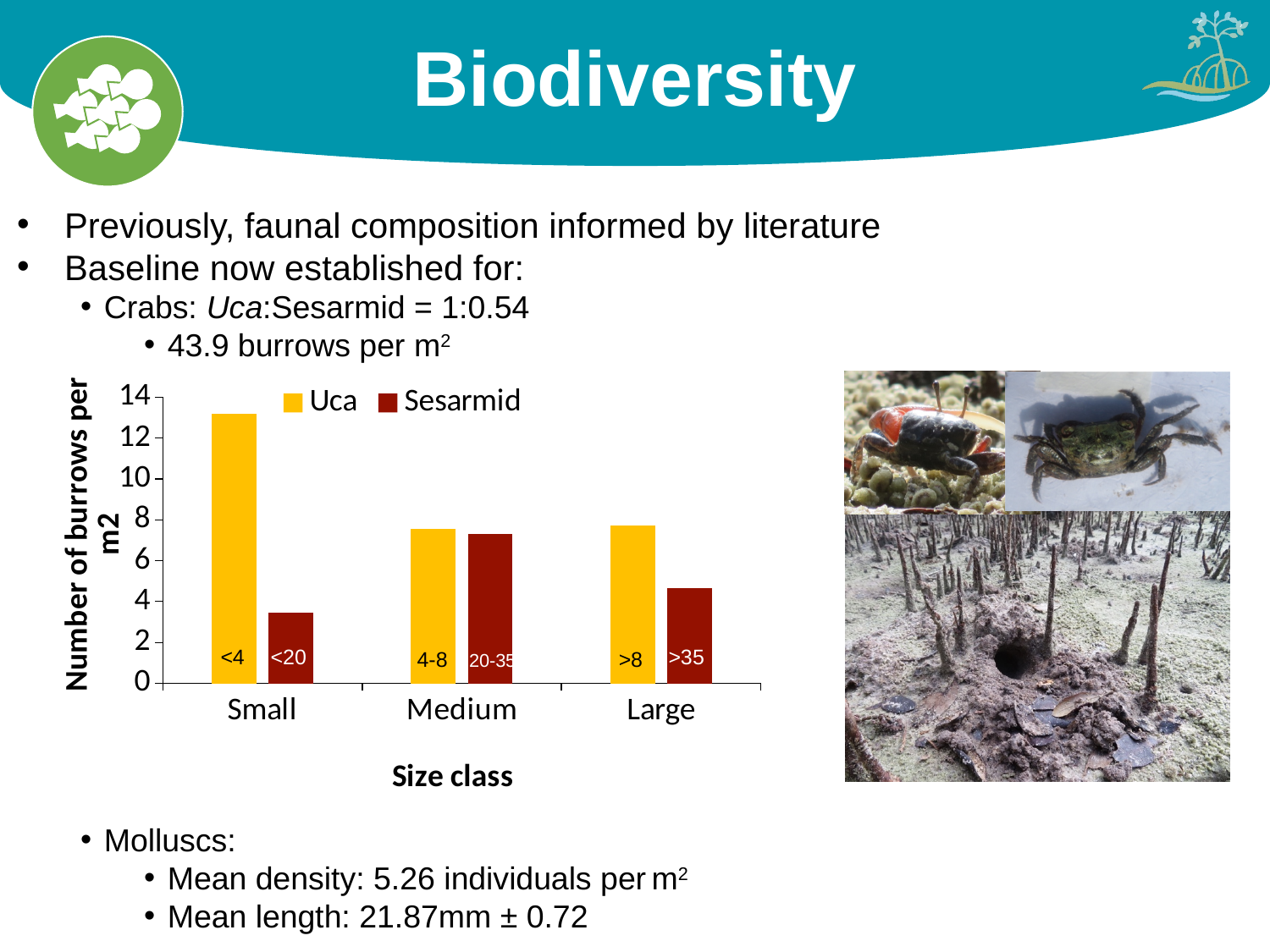
In the Large size class, which series has the larger number of burrows, Uca or Sesarmid? Uca Which colour represents the Sesarmid series in the chart? dark red What kind of chart is shown on the slide? bar chart What is the title of the chart's x axis? Size class How many size classes are shown on the x axis of the chart? 3 How many series does the chart legend list? 2 For which size class is the Sesarmid series highest? Medium Is the Uca value for the Small size class greater or less than 12? greater For which size class is the Sesarmid series lowest? Small For which size class is the Uca series highest? Small In the Small size class, which series has the larger number of burrows, Uca or Sesarmid? Uca Is the Sesarmid value for the Small size class greater or less than 4? less